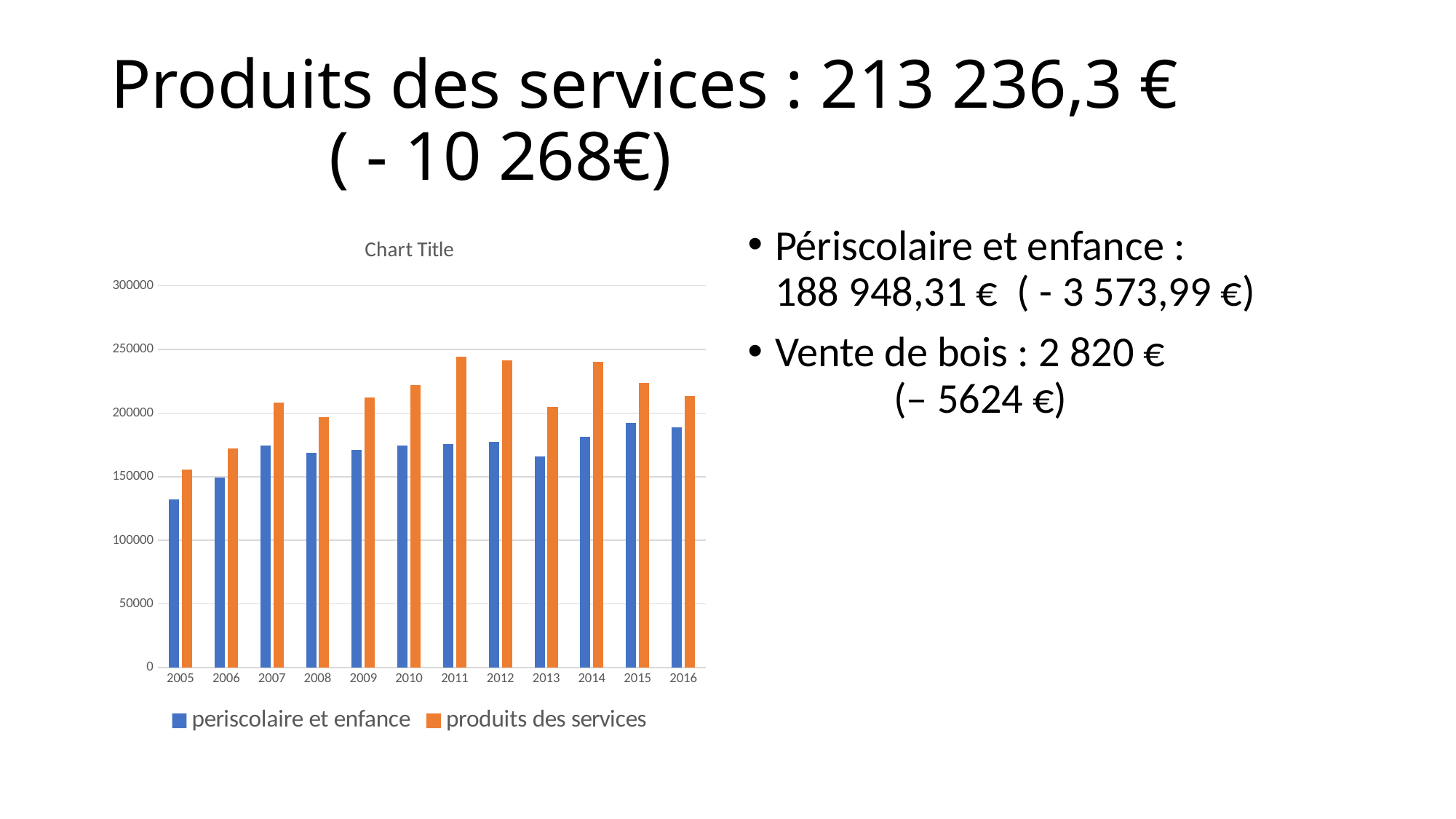
How many years are shown on the x axis of the chart? 12 Which year has the lowest value for produits des services? 2005 In 2016, which series has the larger value: periscolaire et enfance or produits des services? produits des services Do the values for produits des services rise or fall from 2005 to 2011? rise Which year has the lowest value for periscolaire et enfance? 2005 Is the value for periscolaire et enfance in 2016 greater or less than 200000? less Is the value for periscolaire et enfance in 2005 greater or less than 150000? less Is the value for produits des services in 2011 greater or less than 200000? greater What kind of chart is shown on the slide? bar chart How many series does the chart legend list? 2 Which series is shown in blue in the chart? periscolaire et enfance